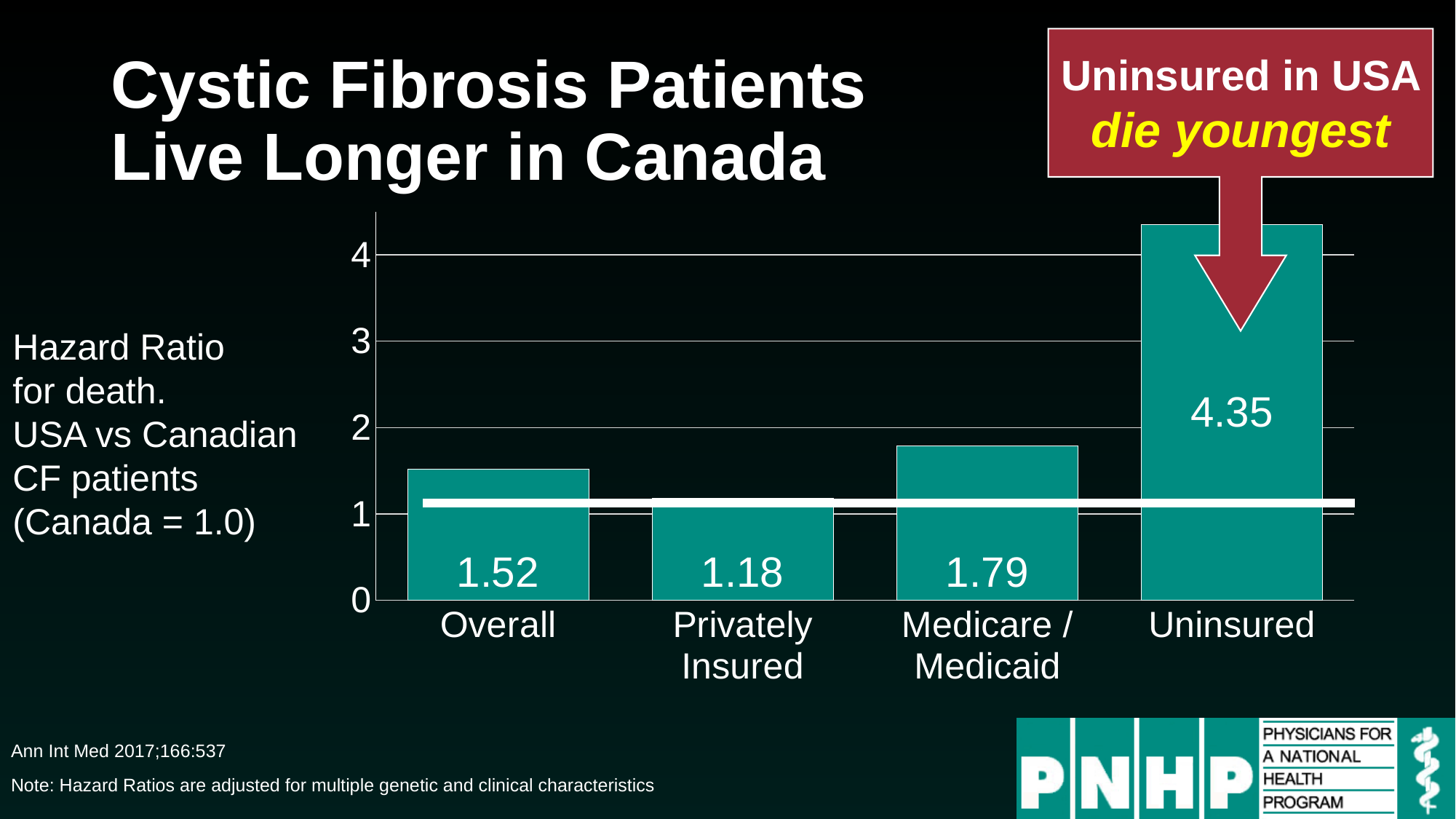
What is the hazard ratio for death for Privately Insured patients? 1.18 What is the difference between the hazard ratios for Medicare / Medicaid and Overall? 0.27 What is the Overall hazard ratio for death? 1.52 What is the hazard ratio for death for Uninsured patients? 4.35 Which category has the lowest hazard ratio? Privately Insured What kind of chart is shown on the slide? Bar chart What is the difference between the hazard ratios for Uninsured and Privately Insured patients? 3.17 Which category has the highest hazard ratio? Uninsured What is the hazard ratio for death for Medicare / Medicaid patients? 1.79 How many categories are shown on the x axis of the chart? 4 Is the hazard ratio for Uninsured patients greater or less than 4? greater Which is larger, the hazard ratio for Medicare / Medicaid or for Overall? Medicare / Medicaid